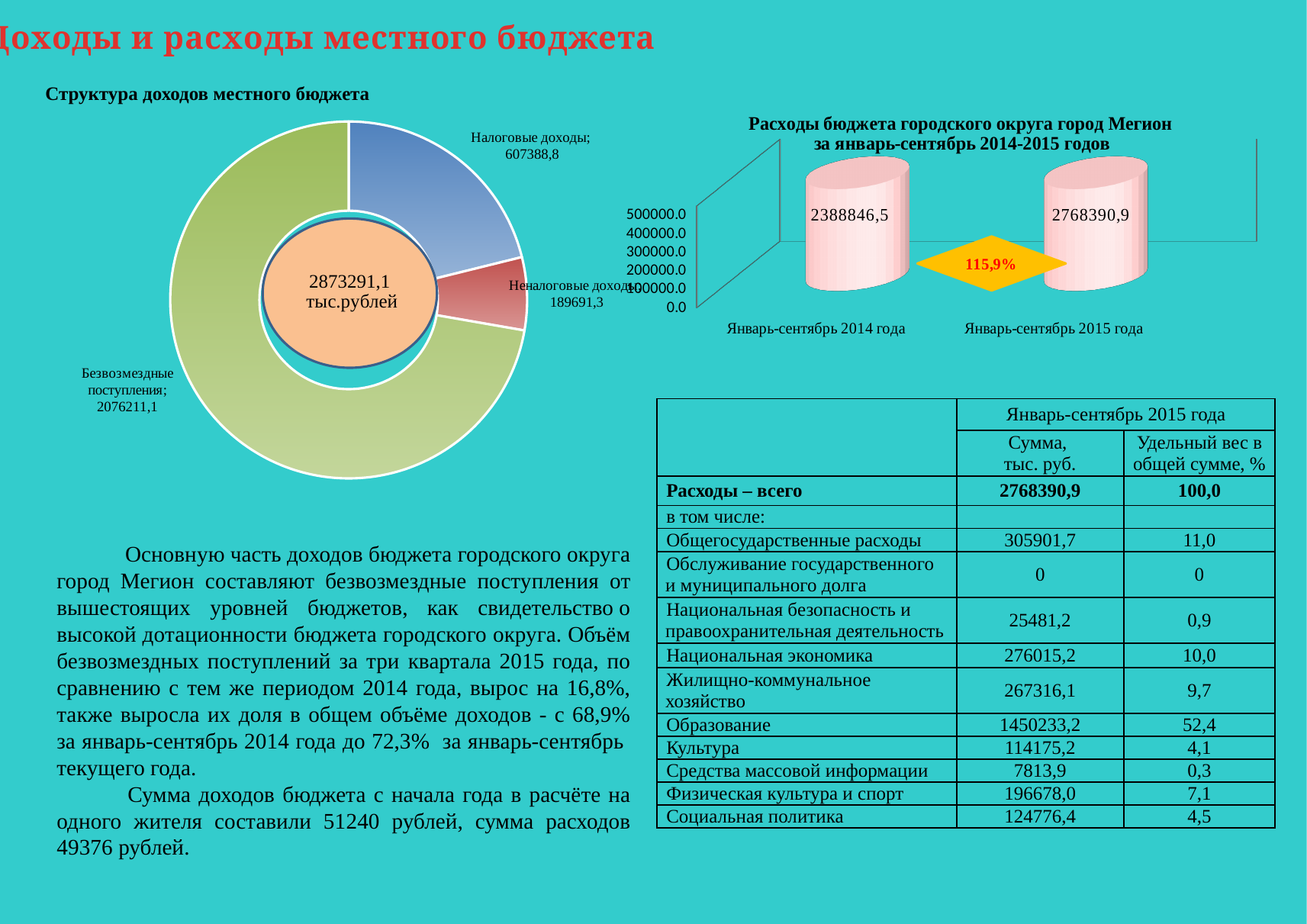
In the chart 'Структура доходов местного бюджета', what is the difference between Налоговые доходы and Неналоговые доходы? 417697,5 In the chart 'Структура доходов местного бюджета', what is the value for Неналоговые доходы? 189691,3 In the chart 'Структура доходов местного бюджета', what is the value for Налоговые доходы? 607388,8 In the chart 'Структура доходов местного бюджета', what total is printed in the centre of the chart? 2873291,1 тыс.рублей In the chart 'Структура доходов местного бюджета', which category has the largest value? Безвозмездные поступления In the chart 'Расходы бюджета городского округа город Мегион за январь-сентябрь 2014-2015 годов', what is the value for Январь-сентябрь 2015 года? 2768390,9 In the chart 'Структура доходов местного бюджета', which category has the smallest value? Неналоговые доходы In the chart 'Расходы бюджета городского округа город Мегион за январь-сентябрь 2014-2015 годов', what percentage is printed on the diamond between the two bars? 115,9% In the chart 'Структура доходов местного бюджета', what is the value for Безвозмездные поступления? 2076211,1 In the chart 'Структура доходов местного бюджета', how many categories are shown? 3 In the chart 'Расходы бюджета городского округа город Мегион за январь-сентябрь 2014-2015 годов', what is the difference between the 2015 and 2014 values? 379544,4 In the chart 'Расходы бюджета городского округа город Мегион за январь-сентябрь 2014-2015 годов', what is the value for Январь-сентябрь 2014 года? 2388846,5